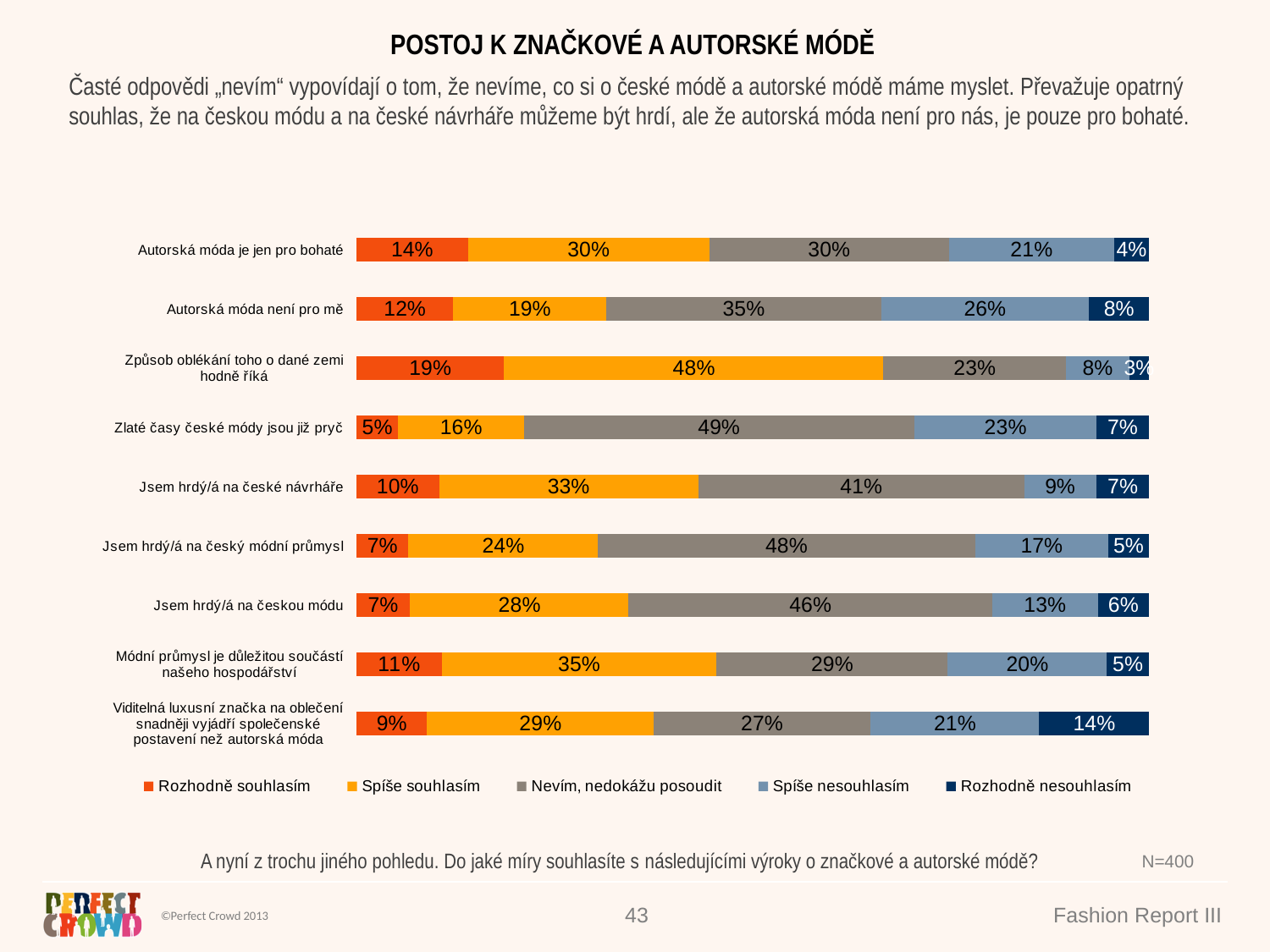
What is the "Spíše souhlasím" value for "Způsob oblékání toho o dané zemi hodně říká"? 48% What is the "Rozhodně nesouhlasím" value for "Viditelná luxusní značka na oblečení snadněji vyjádří společenské postavení než autorská móda"? 14% What is the difference between the "Spíše nesouhlasím" values for "Autorská móda není pro mě" and "Jsem hrdý/á na české návrháře"? 17% How many statements are shown in the chart? 9 What kind of chart is shown on the slide? Stacked bar chart Which statement has the lowest "Rozhodně souhlasím" share? Zlaté časy české módy jsou již pryč What percentage of respondents answered "Rozhodně souhlasím" to the statement "Autorská móda je jen pro bohaté"? 14% How many series does the legend list? 5 What is the "Nevím, nedokážu posoudit" value for "Zlaté časy české módy jsou již pryč"? 49% Which is larger: the "Spíše souhlasím" value for "Módní průmysl je důležitou součástí našeho hospodářství" or for "Jsem hrdý/á na českou módu"? Módní průmysl je důležitou součástí našeho hospodářství What is the combined share of "Rozhodně souhlasím" and "Spíše souhlasím" for "Jsem hrdý/á na české návrháře"? 43% Which statement has the highest "Rozhodně souhlasím" share? Způsob oblékání toho o dané zemi hodně říká